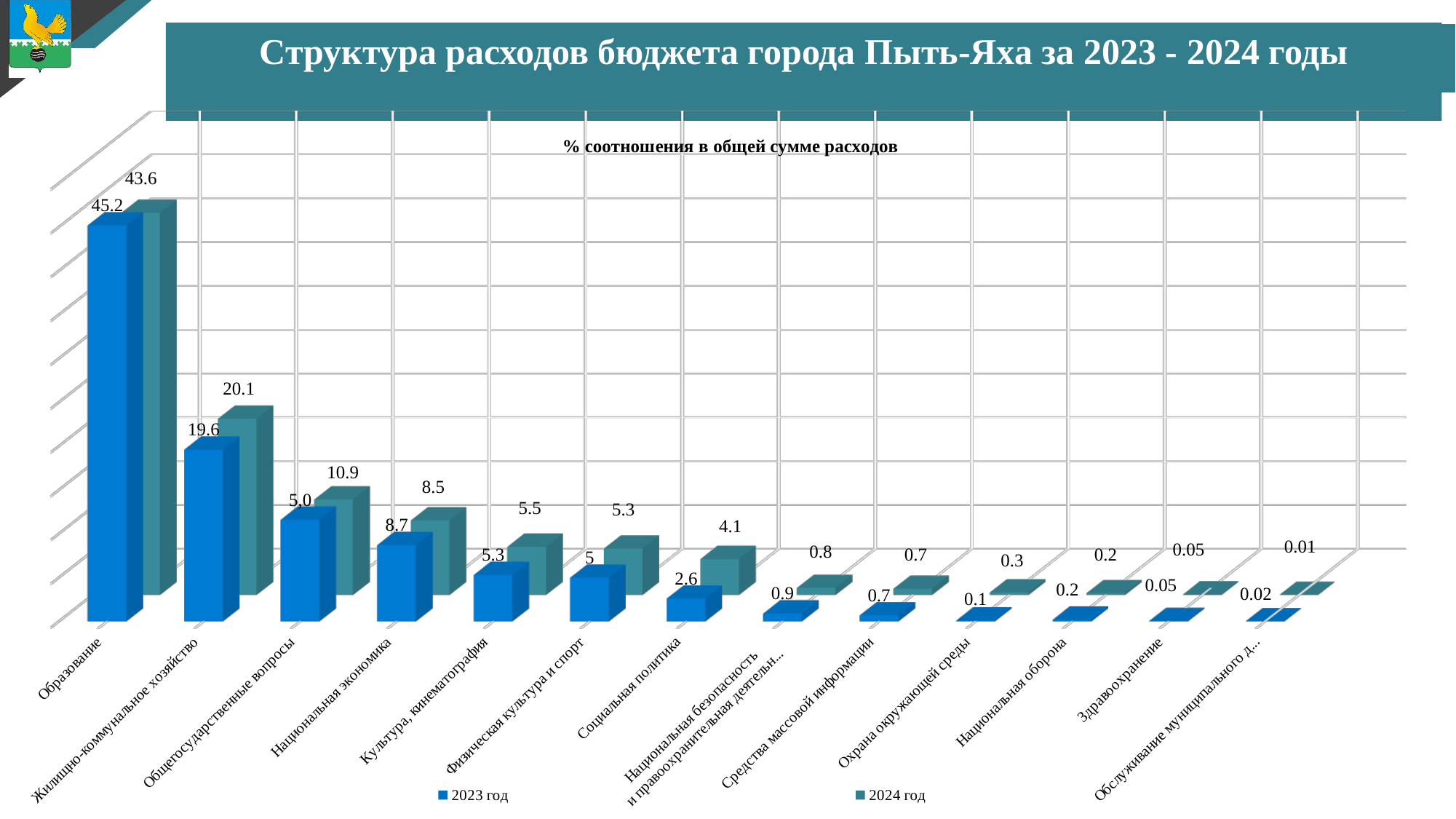
Which category has the lowest value in the 2024 год series? Обслуживание муниципального д... For Жилищно-коммунальное хозяйство, which series has the larger value, 2023 год or 2024 год? 2024 год What is the value for Общегосударственные вопросы in the 2024 год series? 10.9 What is the value for Социальная политика in the 2023 год series? 2.6 Which category has the highest value in the 2024 год series? Образование How many series does the legend list? 2 What is the value for Образование in the 2023 год series? 45.2 What is the value for Здравоохранение in the 2024 год series? 0.05 What kind of chart is shown on the slide? Bar chart What is the subtitle printed above the plot area of the chart? % соотношения в общей сумме расходов How many categories are shown on the x axis? 13